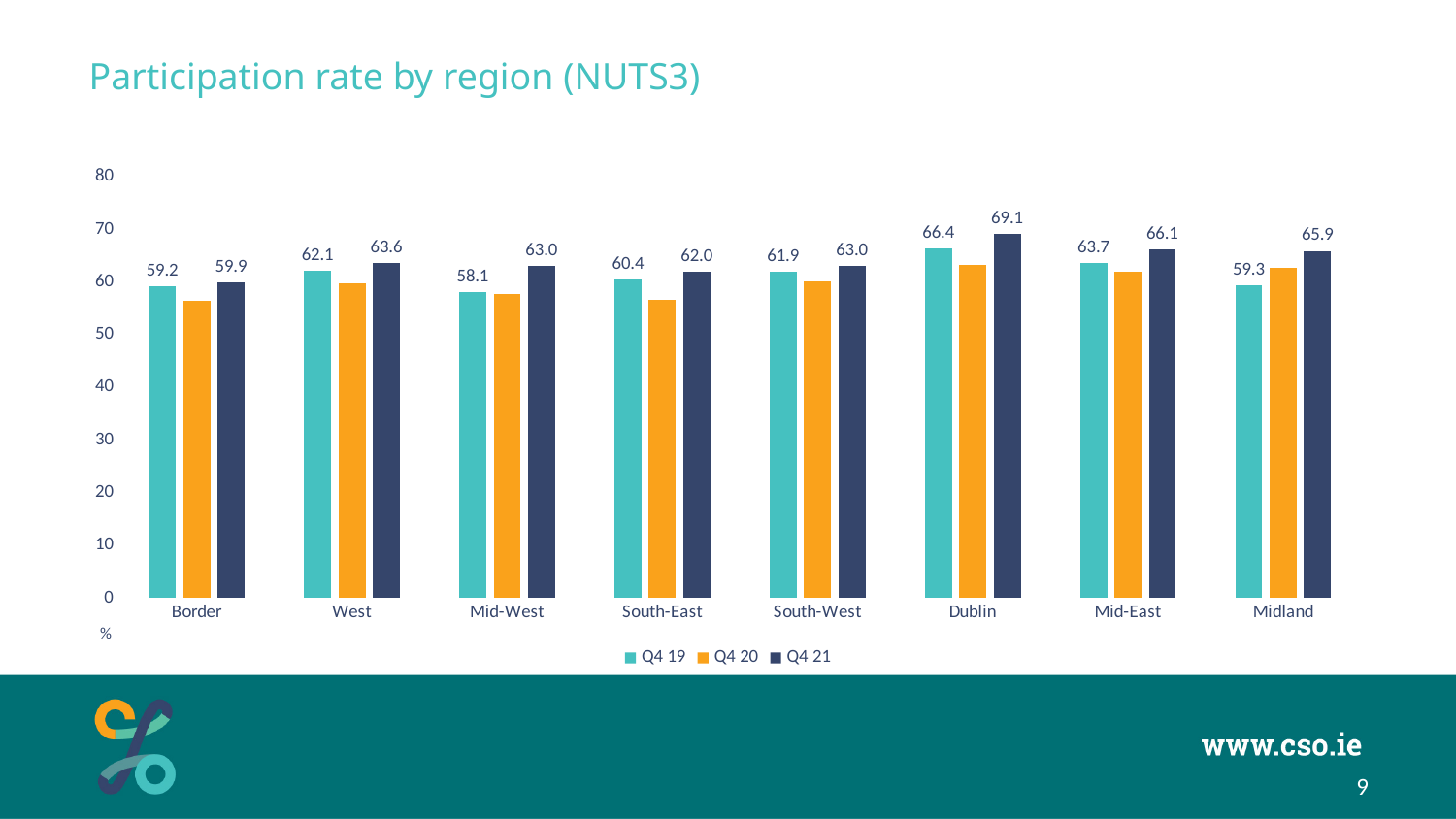
How many regions are shown on the x axis? 8 How many series does the legend list? 3 What is the Q4 21 value for Midland? 65.9 What is the Q4 19 participation rate for Mid-West? 58.1 Which is larger, the Q4 21 value for Mid-East or the Q4 21 value for West? Mid-East What is the Q4 21 participation rate for Dublin? 69.1 Which region has the lowest Q4 19 participation rate? Mid-West Is the Q4 20 value for Border greater or less than 60? less Which region has the highest Q4 21 participation rate? Dublin What is the difference between the Q4 21 and Q4 19 participation rates for Dublin? 2.7 What is the difference between the Q4 21 and Q4 19 participation rates for Midland? 6.6 What kind of chart is shown on the slide? Bar chart